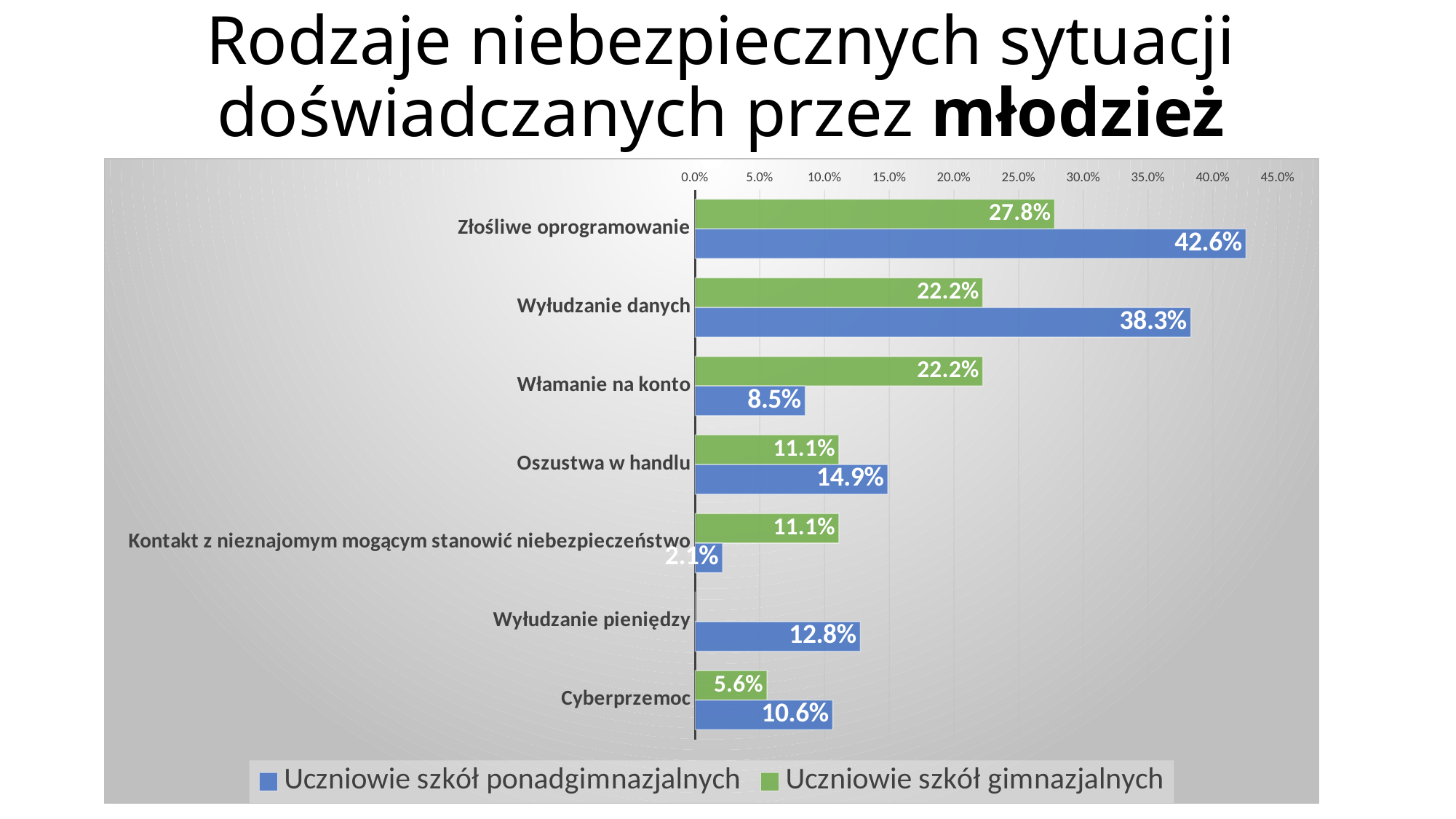
How many series does the legend list? 2 What is the difference between the Uczniowie szkół ponadgimnazjalnych and Uczniowie szkół gimnazjalnych values for Wyłudzanie danych? 16.1% Which category has the highest value for Uczniowie szkół ponadgimnazjalnych? Złośliwe oprogramowanie What is the value for Włamanie na konto for Uczniowie szkół gimnazjalnych? 22.2% What kind of chart is shown on the slide? bar chart What is the value for Cyberprzemoc for Uczniowie szkół ponadgimnazjalnych? 10.6% For Włamanie na konto, which series has the larger value: Uczniowie szkół ponadgimnazjalnych or Uczniowie szkół gimnazjalnych? Uczniowie szkół gimnazjalnych How many categories are shown on the chart? 7 Is the value for Wyłudzanie danych for Uczniowie szkół ponadgimnazjalnych greater or less than 35.0%? greater What is the value for Złośliwe oprogramowanie for Uczniowie szkół ponadgimnazjalnych? 42.6% Which category has the lowest value for Uczniowie szkół ponadgimnazjalnych? Kontakt z nieznajomym mogącym stanowić niebezpieczeństwo Which colour represents Uczniowie szkół gimnazjalnych in the chart? green